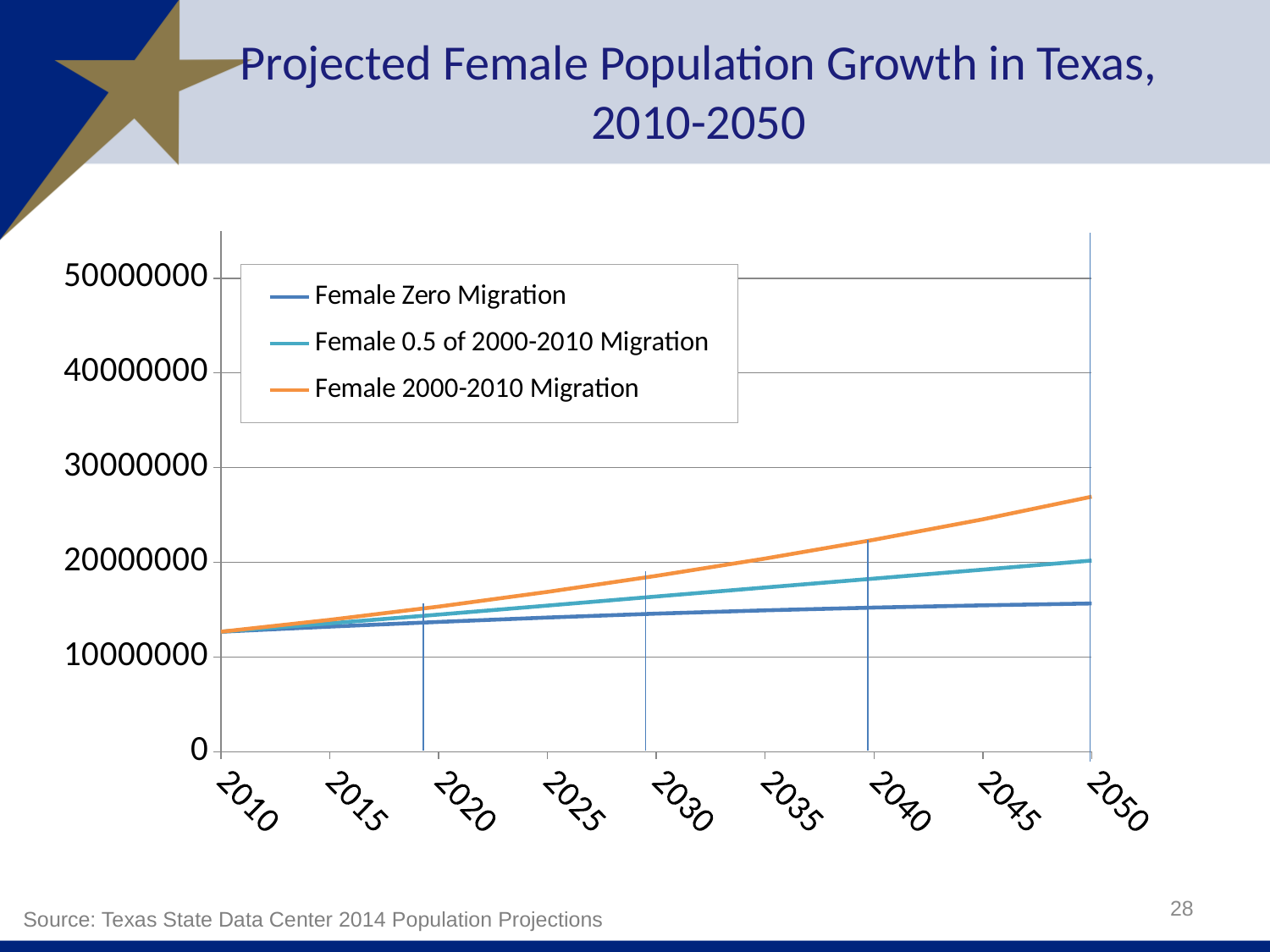
What colour is the line for Female 2000-2010 Migration? orange Which series has the highest value in 2050? Female 2000-2010 Migration How many series does the legend list? 3 How many year labels are shown along the x axis? 9 What kind of chart is shown on the slide? line chart Is the value for Female 2000-2010 Migration in 2050 greater or less than 20000000? greater Do the values for Female 2000-2010 Migration rise or fall from 2010 to 2050? rise In 2040, which is larger: Female 2000-2010 Migration or Female Zero Migration? Female 2000-2010 Migration Which series has the lowest value in 2050? Female Zero Migration What is the title of the chart? Projected Female Population Growth in Texas, 2010-2050 Is the value for Female 2000-2010 Migration in 2030 greater or less than 20000000? less Is the value for Female Zero Migration in 2050 greater or less than 20000000? less